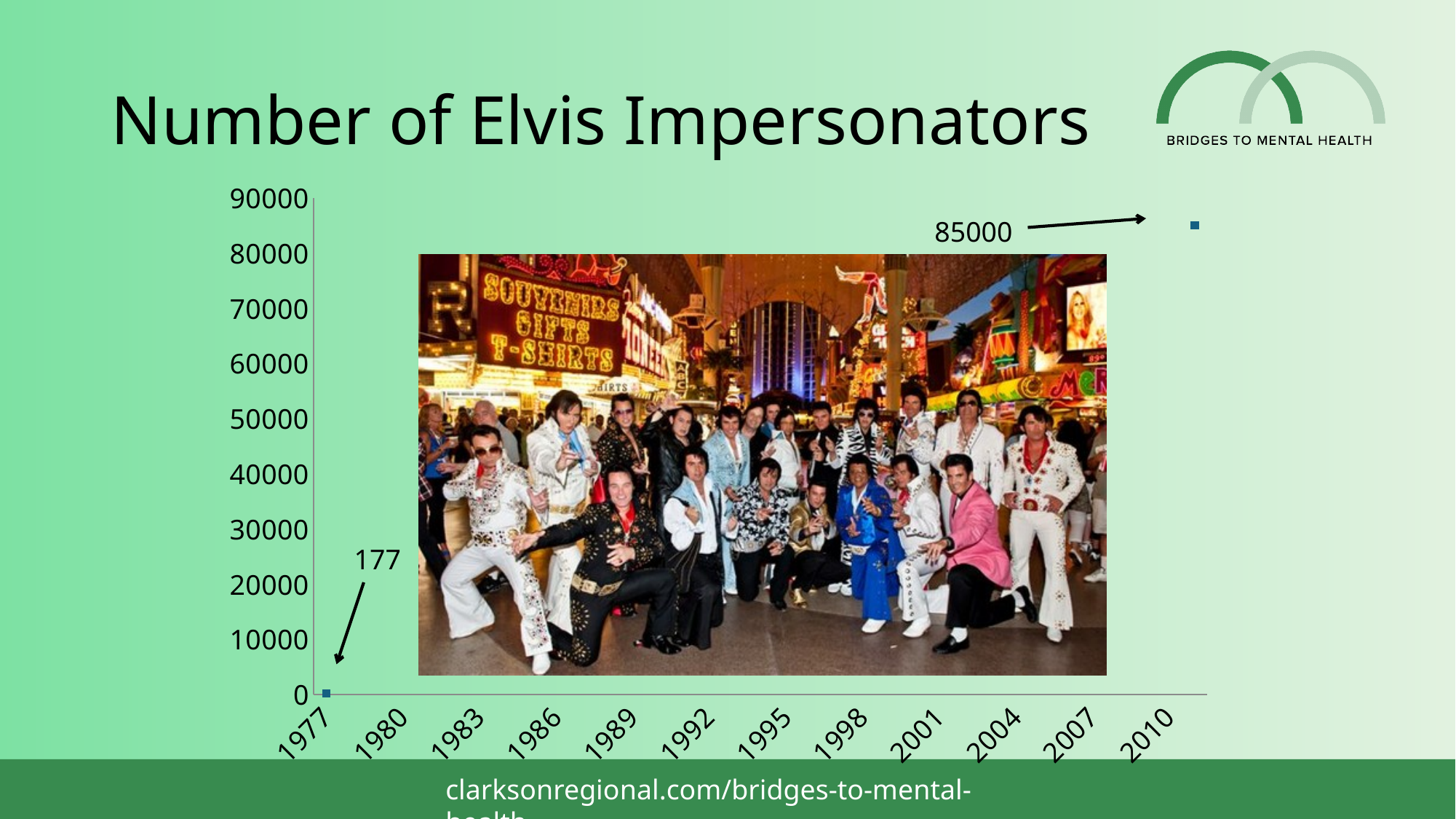
What is the number of Elvis impersonators shown for 1977? 177 How many data points are plotted on the chart? 2 What is the title of the chart? Number of Elvis Impersonators Is the value of the rightmost data point greater or less than 80000? greater What kind of chart is shown on the slide? line chart What value is labelled for the rightmost data point on the chart? 85000 What is the difference between the two labelled values, 85000 and 177? 84823 Is the value for 1977 greater or less than 10000? less Is the value for 1977 larger or smaller than the value for the rightmost point? smaller Which data point has the highest value, the one at 1977 or the one at the right end of the chart? the one at the right end Which data point has the lowest value on the chart? 1977 Do the plotted values rise or fall from left to right along the x axis? rise